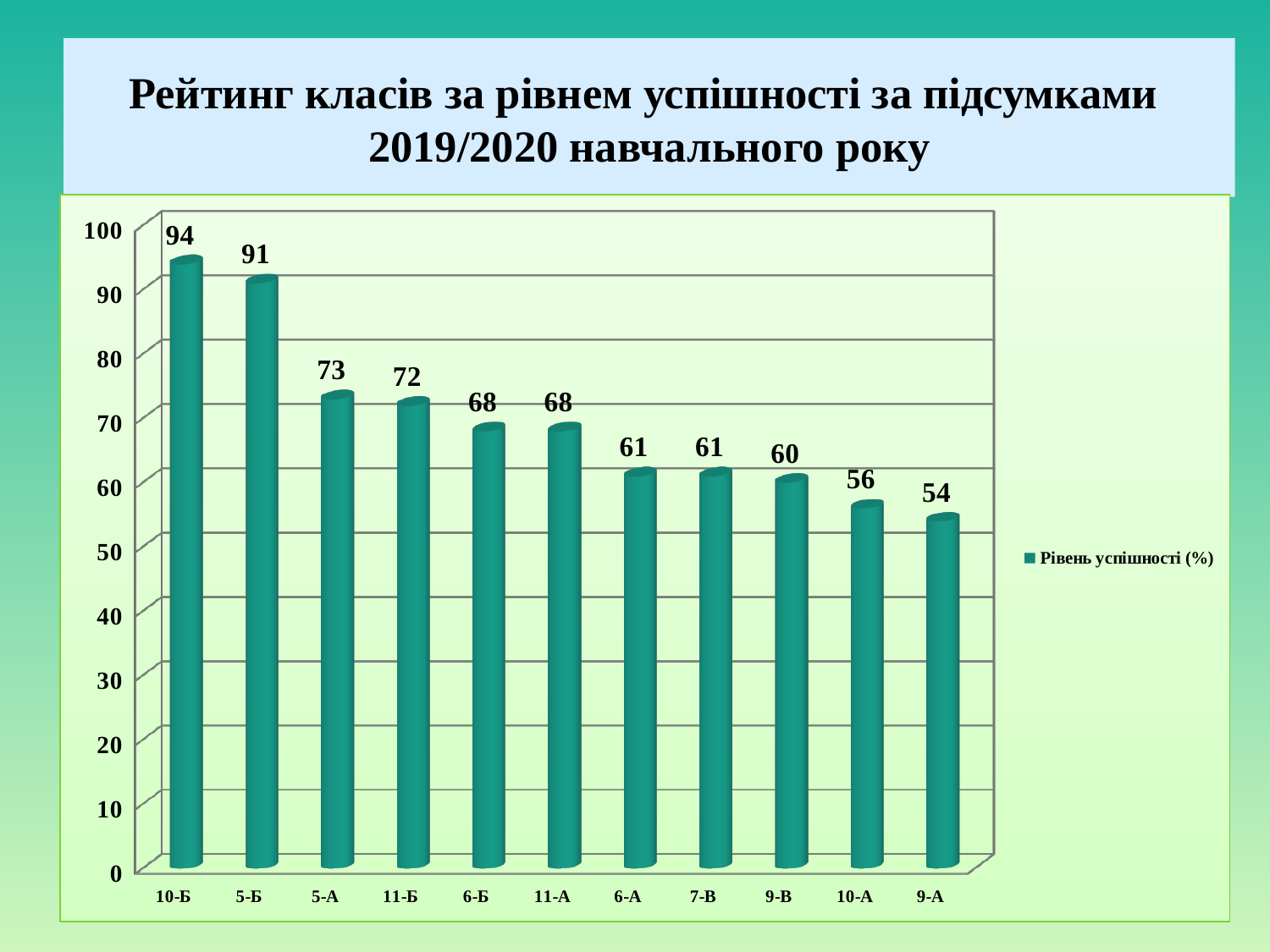
How many classes are shown on the x axis? 11 What is the value for class 11-Б? 72 How many series does the legend list? 1 What is the value for class 10-Б? 94 What is the difference between the values for 10-Б and 9-А? 40 What is the value for class 9-В? 60 What is the difference between the values for 5-Б and 5-А? 18 What kind of chart is shown on the slide? bar chart Do the values rise or fall from left to right along the x axis? fall Which is larger, the value for 6-Б or the value for 10-А? 6-Б Which class has the highest value? 10-Б Which class has the lowest value? 9-А